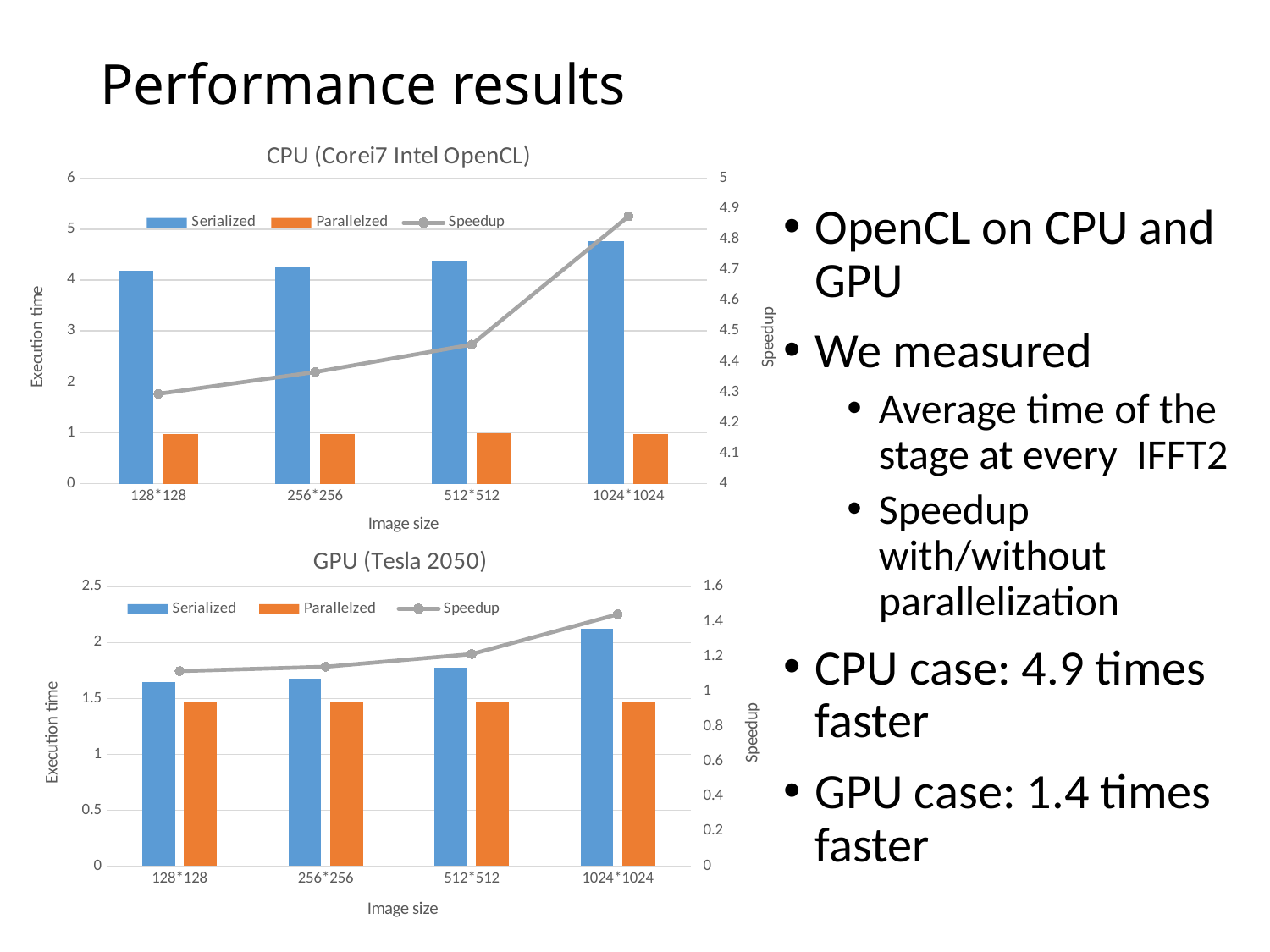
In the GPU (Tesla 2050) chart, which image size has the highest Serialized execution time? 1024*1024 In the CPU (Corei7 Intel OpenCL) chart, how many image sizes are shown on the x axis? 4 In the GPU (Tesla 2050) chart, which is larger for 128*128: the Serialized or the Parallelzed execution time? Serialized In the CPU (Corei7 Intel OpenCL) chart, is the Parallelzed execution time for 128*128 greater or less than 2? less In the CPU (Corei7 Intel OpenCL) chart, does the Speedup line rise or fall as image size increases? rises In the CPU (Corei7 Intel OpenCL) chart, is the Serialized execution time for 1024*1024 greater or less than 4? greater In the CPU (Corei7 Intel OpenCL) chart, how many series does the legend list? 3 In the GPU (Tesla 2050) chart, does the Speedup line rise or fall as image size increases? rises In the GPU (Tesla 2050) chart, is the Serialized execution time for 1024*1024 greater or less than 2? greater What is the x-axis label of the CPU (Corei7 Intel OpenCL) chart? Image size What kind of chart is the GPU (Tesla 2050) chart? bar chart with a line In the CPU (Corei7 Intel OpenCL) chart, which image size has the highest Serialized execution time? 1024*1024